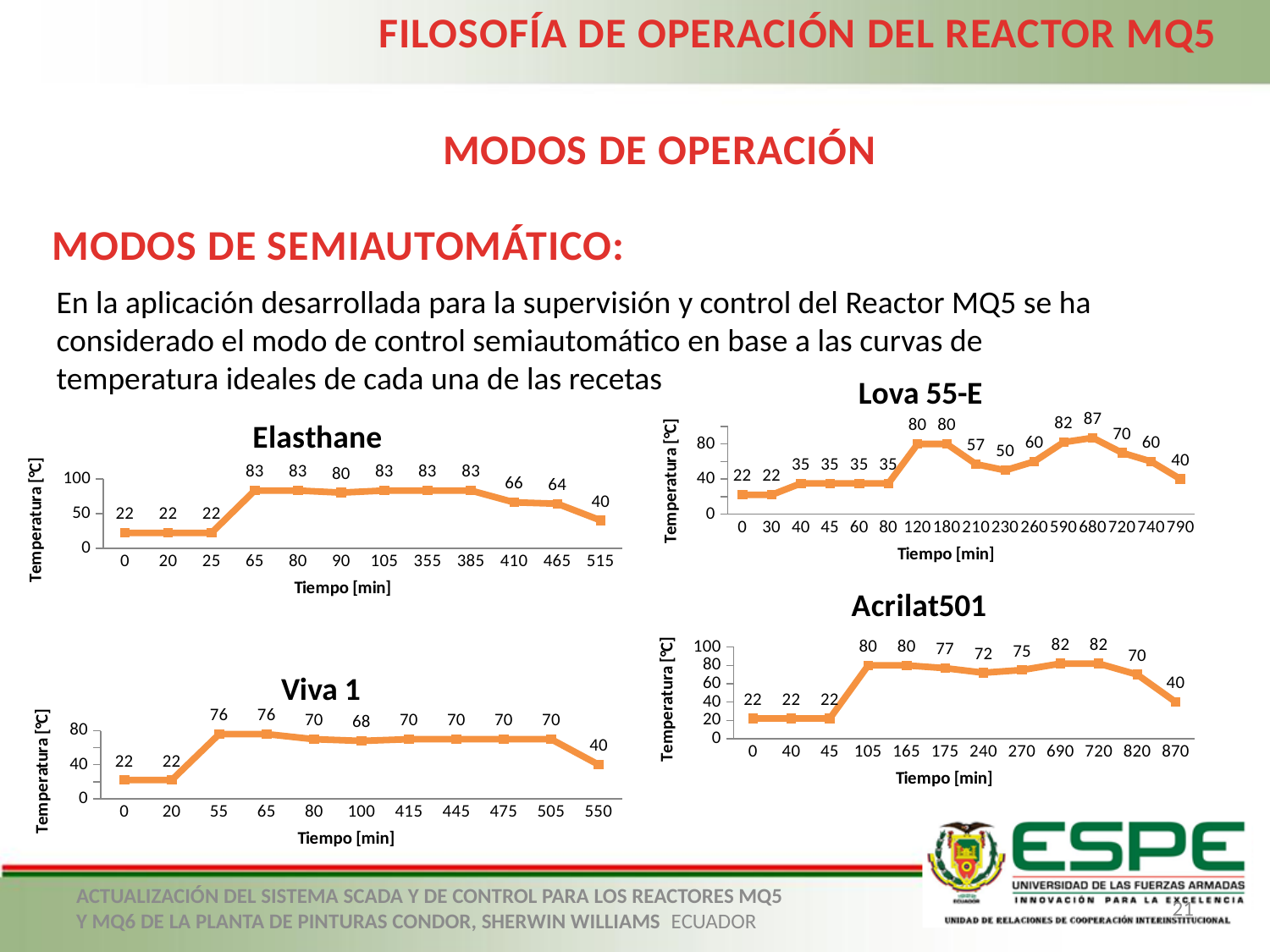
In the Lova 55-E chart, at what time does the temperature reach 87? 680 What type of chart is the Acrilat501 chart? Line chart In the Elasthane chart, which is larger: the temperature at 410 min or at 465 min? 410 min In the Acrilat501 chart, what is the difference between the temperature at 690 min and the temperature at 870 min? 42 In the Lova 55-E chart, what is the highest temperature value shown? 87 What is the y-axis label of the Elasthane chart? Temperatura [°C] How many data points are plotted in the Viva 1 chart? 11 In the Acrilat501 chart, what is the temperature at 240 min? 72 How many data points are plotted in the Lova 55-E chart? 16 In the Viva 1 chart, does the temperature rise or fall between 505 min and 550 min? Fall In the Elasthane chart, what is the temperature at 65 min? 83 In the Viva 1 chart, what is the temperature at 100 min? 68